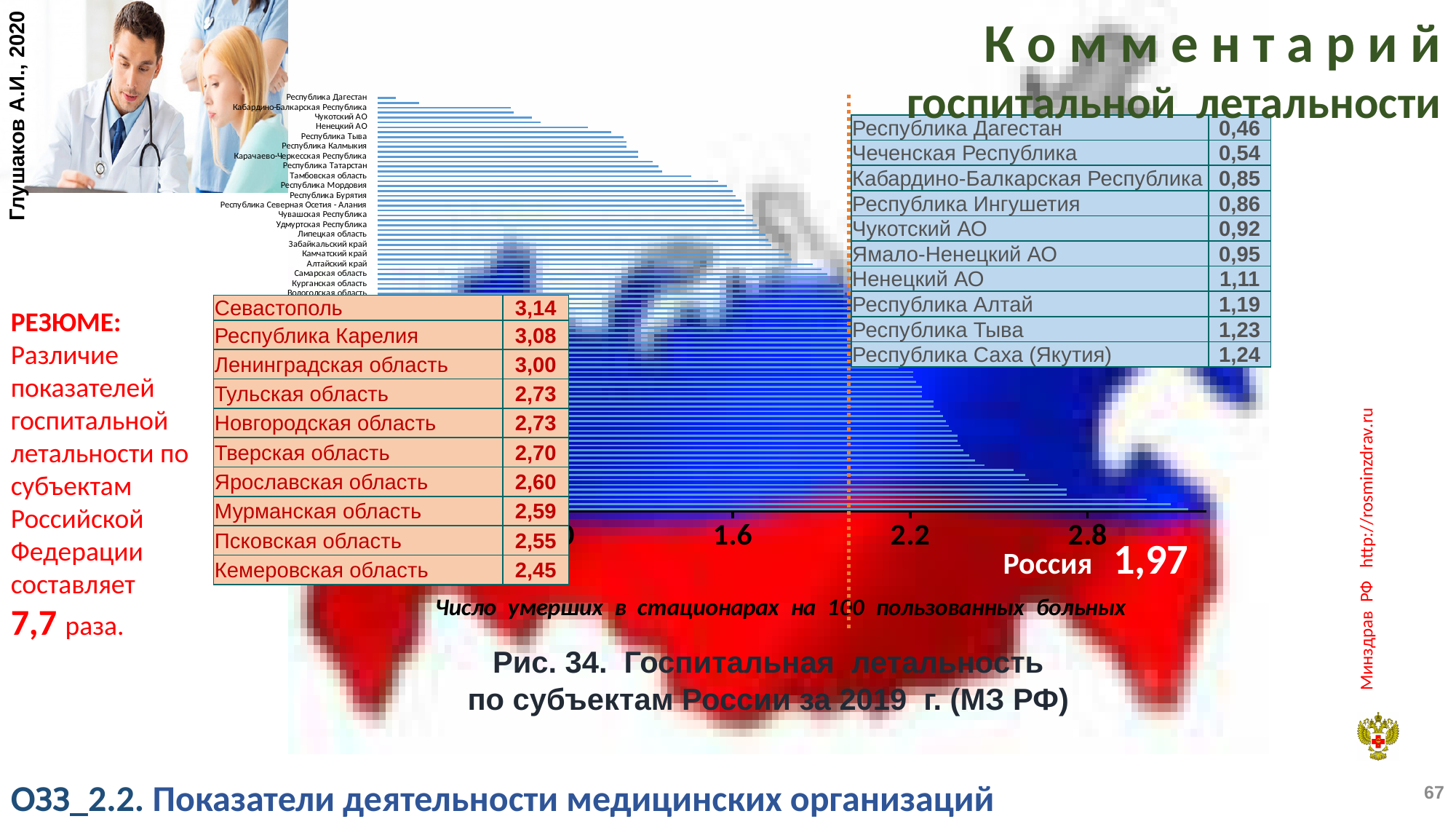
What kind of chart is shown on the slide? Bar chart What is the hospital lethality value for Севастополь? 3,14 What is the hospital lethality value for Чукотский АО? 0,92 What is the difference between the values for Псковская область and Кемеровская область? 0,10 What is the value shown for Россия as a whole? 1,97 What is the label of the horizontal axis of the chart? Число умерших в стационарах на 100 пользованных больных Which has the larger value, Республика Карелия or Ленинградская область? Республика Карелия Which region has the lowest hospital lethality value on the slide? Республика Дагестан What is the difference between the values for Севастополь and Республика Дагестан? 2,68 Is the value for Севастополь greater or less than 2.8? greater What is the hospital lethality value for Республика Дагестан? 0,46 Which region has the highest hospital lethality value on the slide? Севастополь